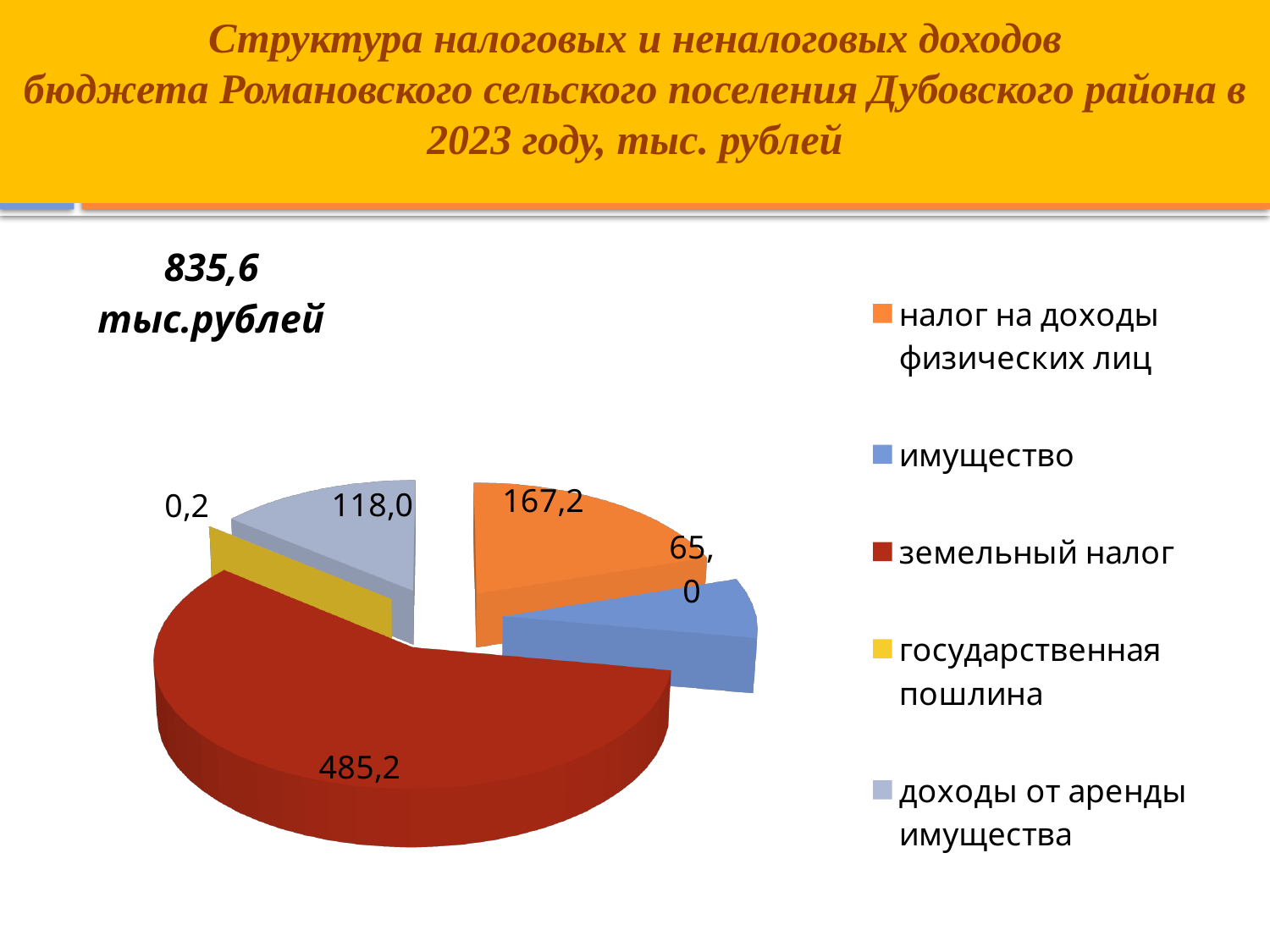
What total amount is printed above the pie chart? 835,6 тыс.рублей What is the difference between земельный налог and налог на доходы физических лиц? 318,0 How many categories does the legend list? 5 What is the value for земельный налог? 485,2 What is the value for государственная пошлина? 0,2 What is the value for доходы от аренды имущества? 118,0 What is the value for имущество? 65,0 What type of chart is shown on the slide? pie chart Which category has the smallest slice of the pie? государственная пошлина What is the value for налог на доходы физических лиц? 167,2 Which category has the largest slice of the pie? земельный налог Which is larger: доходы от аренды имущества or имущество? доходы от аренды имущества